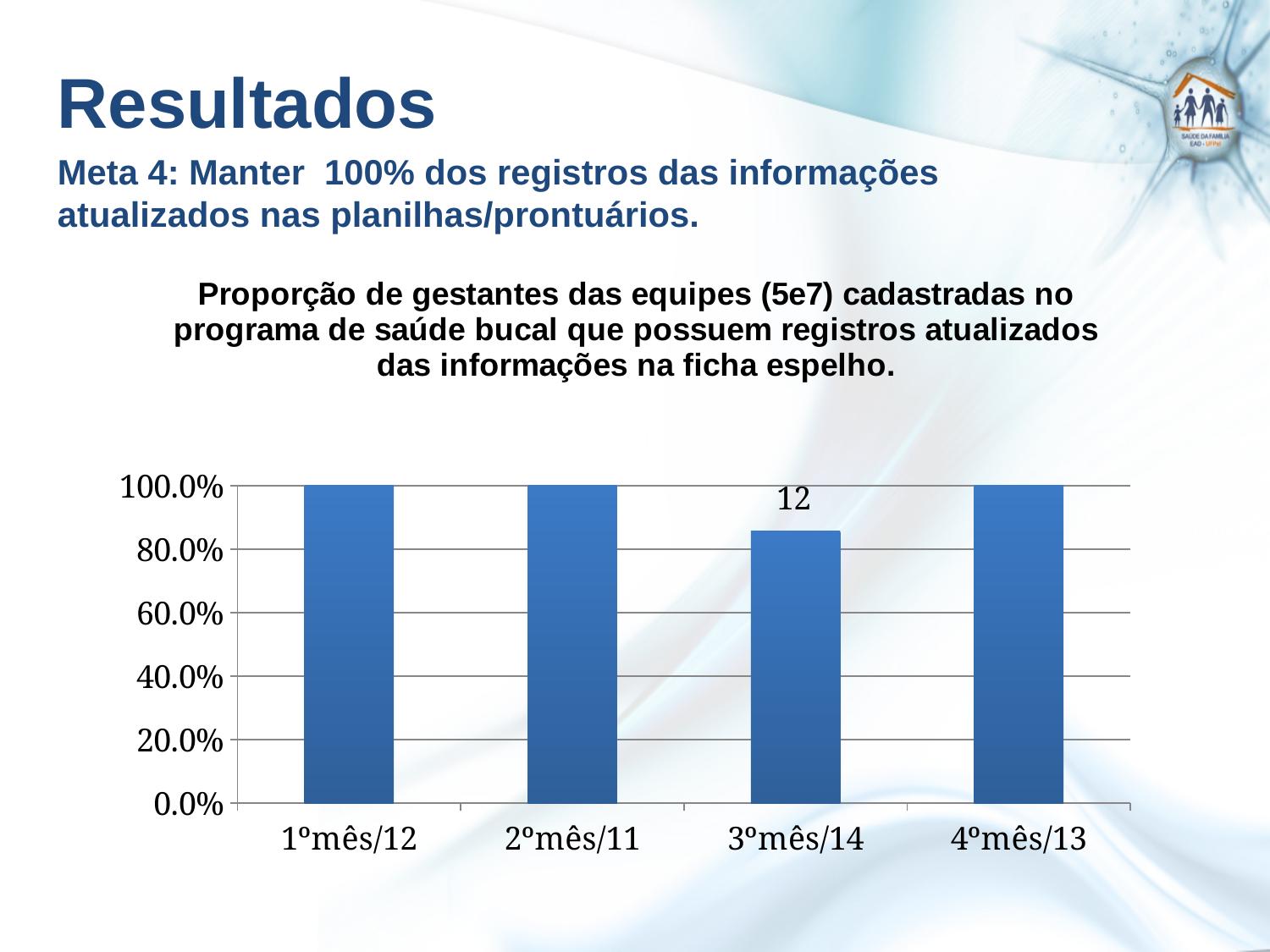
What is the value for 2ºmês/11? 100.0% Does the value rise or fall from 2ºmês/11 to 3ºmês/14? fall What colour are the bars in the chart? blue Which category has the lowest value? 3ºmês/14 How many categories are shown on the x axis of the chart? 4 Which is larger, the value for 1ºmês/12 or the value for 3ºmês/14? 1ºmês/12 What is the value for 4ºmês/13? 100.0% What is the value for 1ºmês/12? 100.0% Is the value for 3ºmês/14 greater or less than 80.0%? greater What type of chart is shown on the slide? bar chart Is the value for 3ºmês/14 greater or less than 100.0%? less What data label is printed above the bar for 3ºmês/14? 12